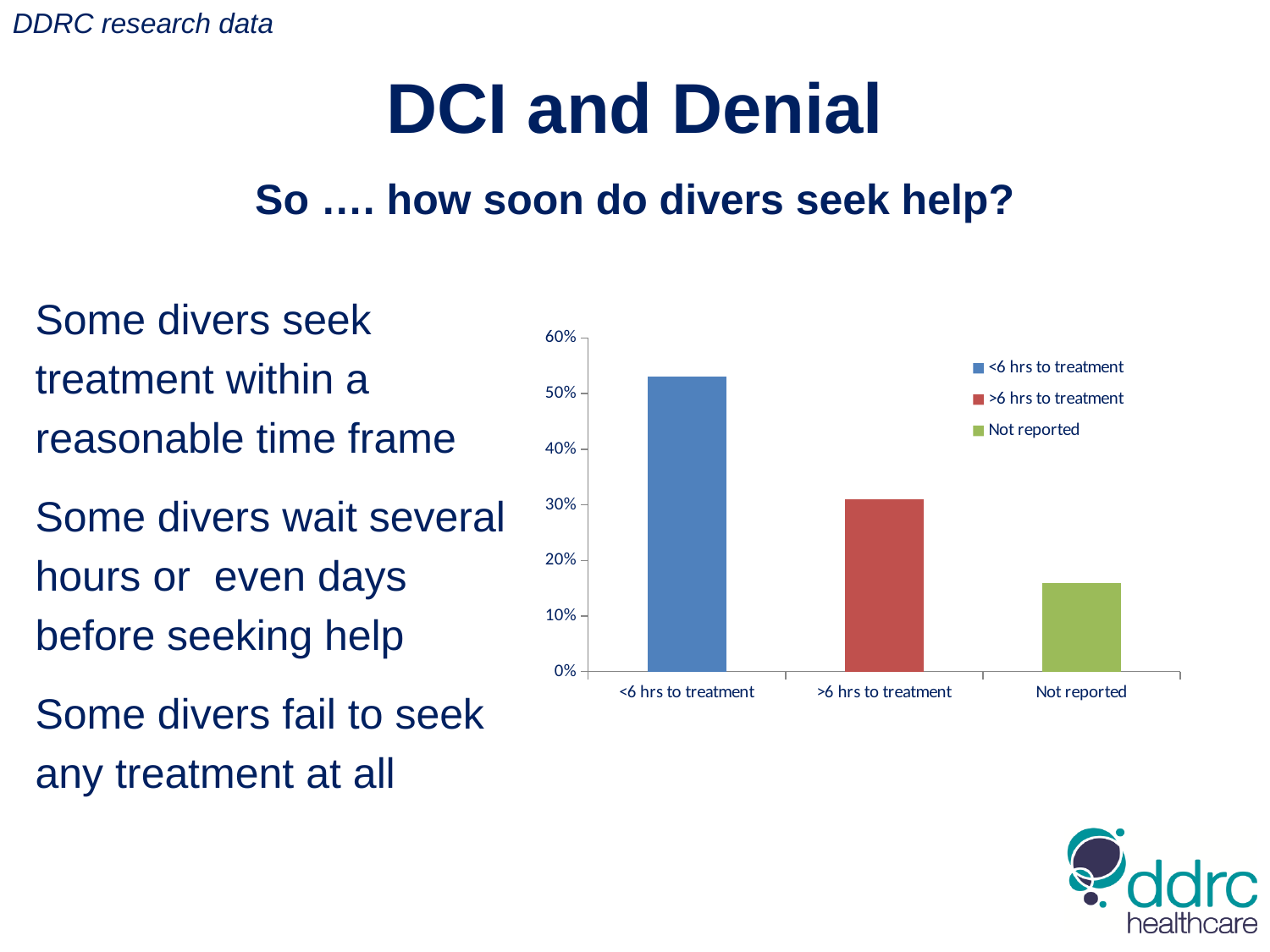
What kind of chart is shown on the slide? bar chart What colour is the bar for >6 hrs to treatment? red Which is larger, the value for >6 hrs to treatment or the value for Not reported? >6 hrs to treatment Is the value for Not reported greater or less than 10%? greater Is the value for Not reported greater or less than 20%? less Is the value for >6 hrs to treatment greater or less than 40%? less Which category has the highest bar in the chart? <6 hrs to treatment How many categories are shown on the x axis of the chart? 3 What is the highest value shown on the chart's y axis? 60% How many entries does the chart's legend list? 3 Which category has the lowest bar in the chart? Not reported